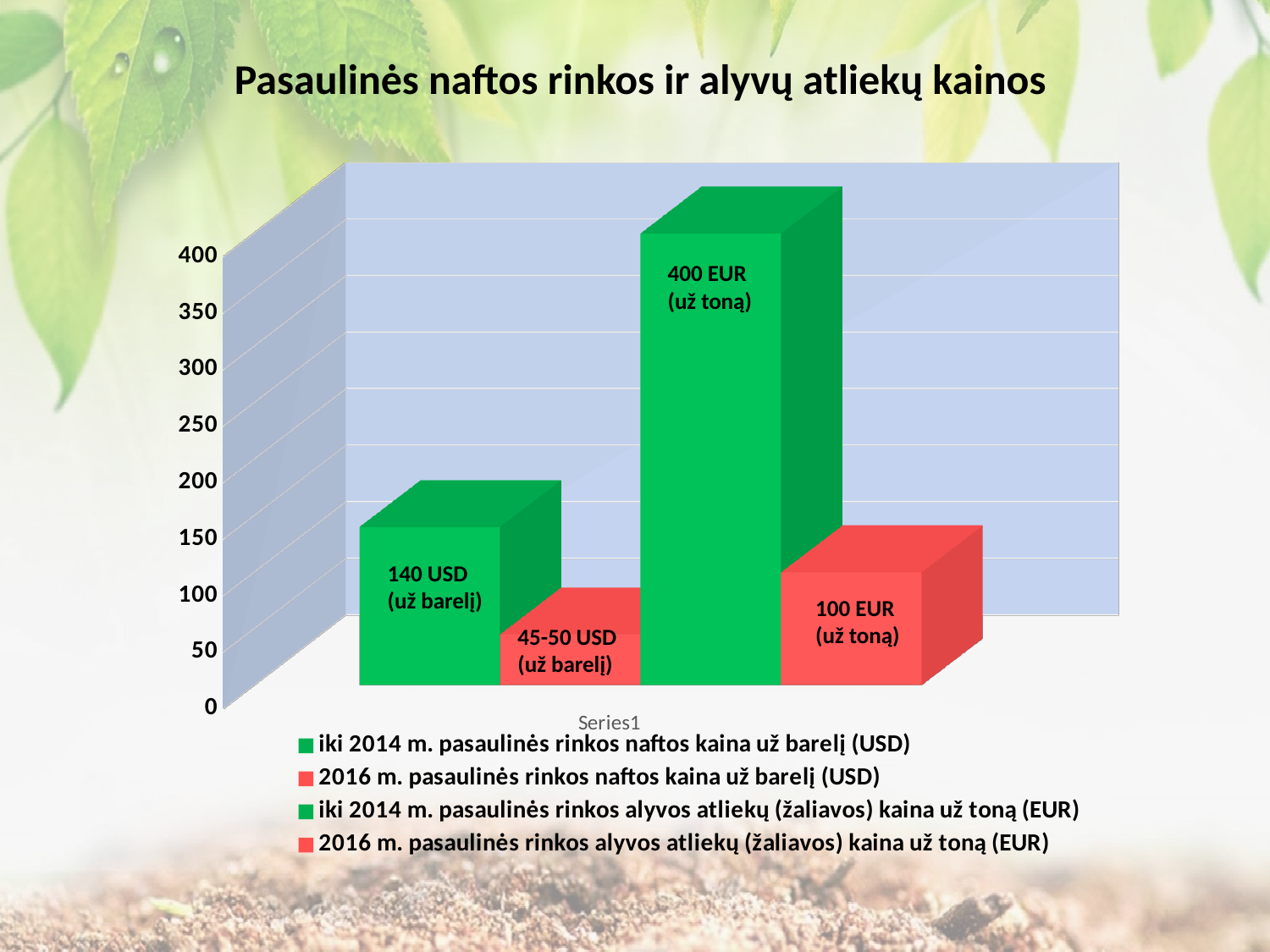
What is the title of the chart? Pasaulinės naftos rinkos ir alyvų atliekų kainos Which series has the shortest bar? 2016 m. pasaulinės rinkos naftos kaina už barelį (USD) What is the difference between the 'iki 2014 m.' and '2016 m.' prices of alyvos atliekų (žaliavos) per tonne? 300 EUR What value is labelled on the bar for 'iki 2014 m. pasaulinės rinkos naftos kaina už barelį (USD)'? 140 USD What value is labelled on the bar for '2016 m. pasaulinės rinkos naftos kaina už barelį (USD)'? 45-50 USD What value is labelled on the bar for '2016 m. pasaulinės rinkos alyvos atliekų (žaliavos) kaina už toną (EUR)'? 100 EUR How many bars are plotted in the chart? 4 Is the bar for '2016 m. pasaulinės rinkos naftos kaina už barelį (USD)' greater or less than 100 on the axis? less How many series does the legend list? 4 What value is labelled on the bar for 'iki 2014 m. pasaulinės rinkos alyvos atliekų (žaliavos) kaina už toną (EUR)'? 400 EUR Which series has the tallest bar? iki 2014 m. pasaulinės rinkos alyvos atliekų (žaliavos) kaina už toną (EUR) What type of chart is shown on the slide? Bar chart